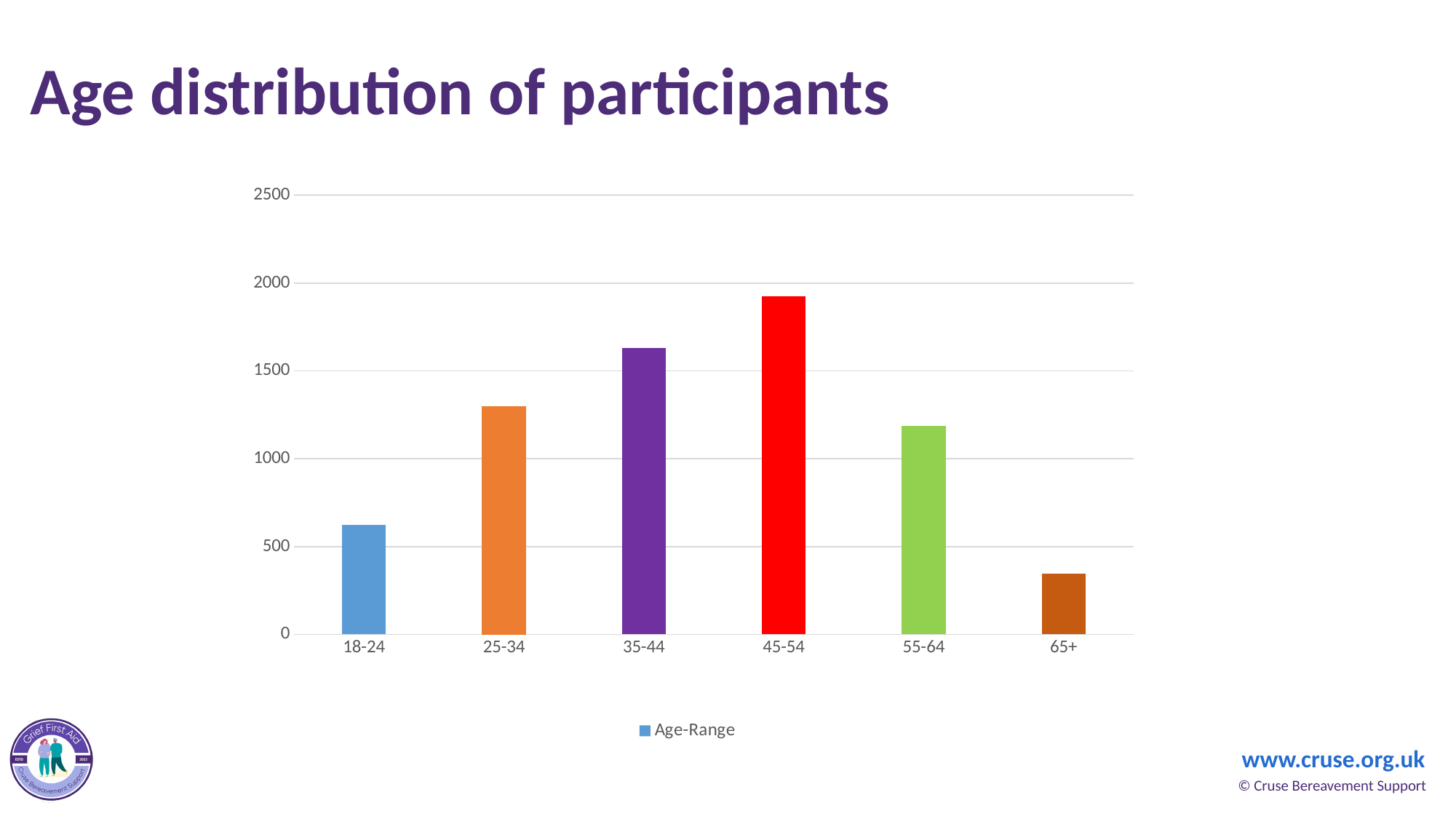
Which age range has the lowest bar? 65+ Which age range has the highest bar? 45-54 What kind of chart is shown on the slide? bar chart Is the value for 25-34 greater or less than 1500? less Is the value for 45-54 greater or less than 2000? less Is the value for 65+ greater or less than 500? less How many age ranges are shown on the x axis? 6 Which is larger, the value for 25-34 or the value for 55-64? 25-34 What is the name of the series shown in the legend? Age-Range How many series does the legend list? 1